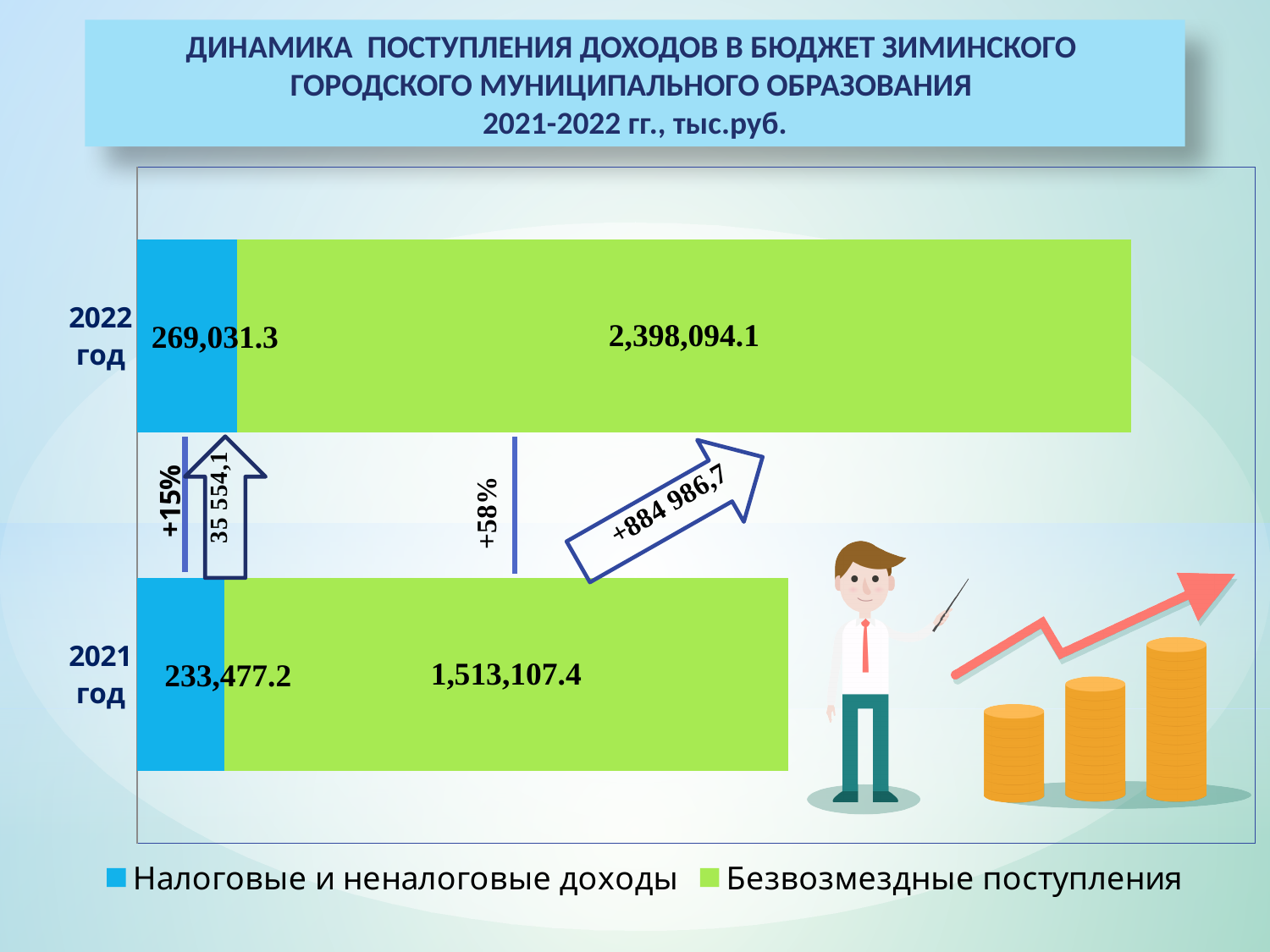
What kind of chart is shown on the slide? Stacked bar chart What is the value of Безвозмездные поступления for 2021 год? 1,513,107.4 What percentage growth is shown for Безвозмездные поступления between 2021 and 2022? +58% What is the value of Налоговые и неналоговые доходы for 2022 год? 269,031.3 What is the total of the stacked bar for 2021 год? 1,746,584.6 What is the value of Безвозмездные поступления for 2022 год? 2,398,094.1 What is the value of Налоговые и неналоговые доходы for 2021 год? 233,477.2 Which year has the higher value for Безвозмездные поступления? 2022 год What is the difference between the Налоговые и неналоговые доходы values for 2022 год and 2021 год? 35,554.1 What is the difference between the Безвозмездные поступления values for 2022 год and 2021 год? 884,986.7 How many series does the legend list? 2 What is the total of the stacked bar for 2022 год? 2,667,125.4